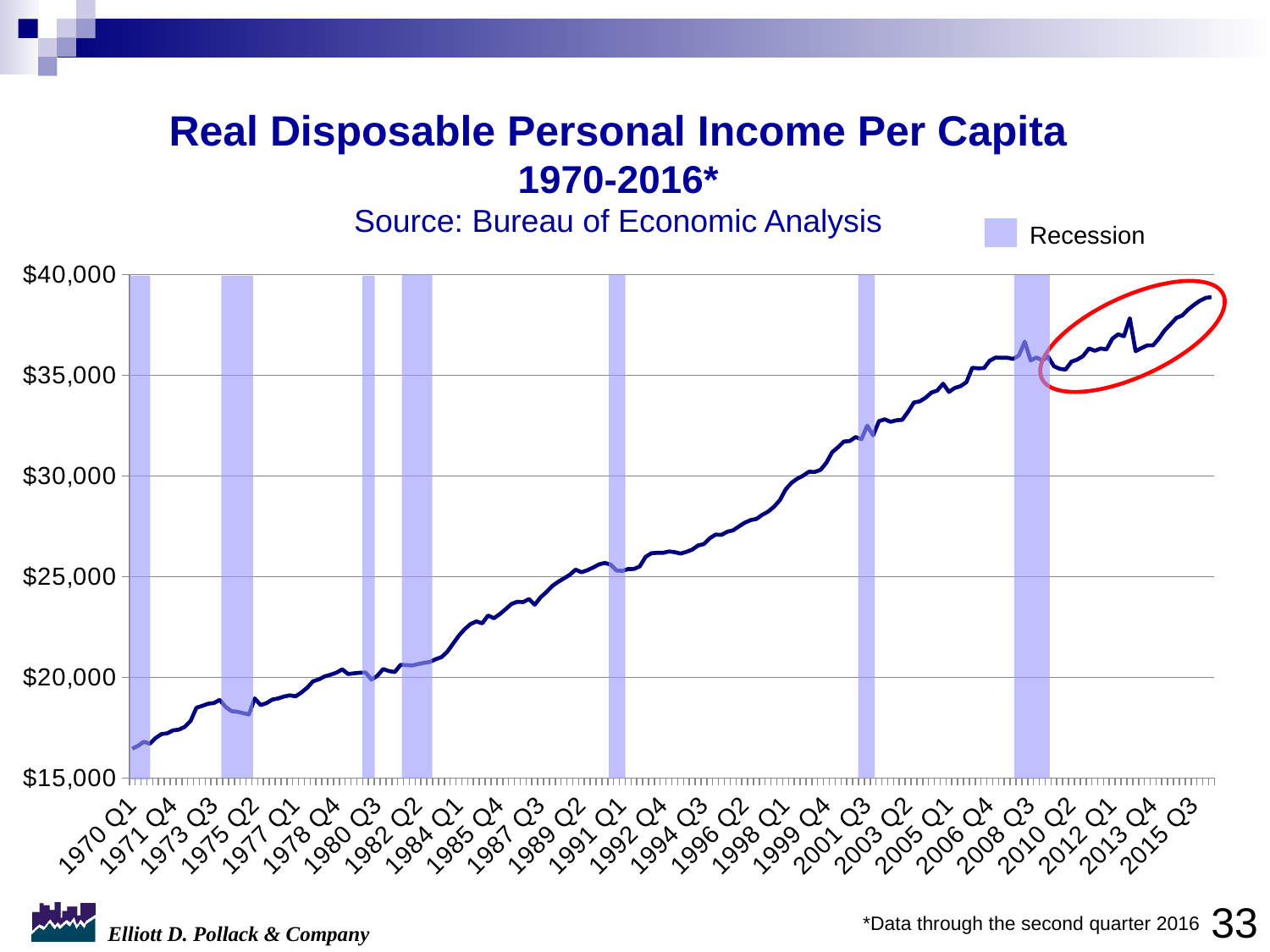
Is the value for 2015 Q3 greater or less than $35,000? greater What does the shaded area in the legend represent? Recession What is the title of the chart? Real Disposable Personal Income Per Capita 1970-2016* Is the value for 1970 Q1 greater or less than $20,000? less Which is larger, the value for 2015 Q3 or the value for 1970 Q1? 2015 Q3 Is the value for 1996 Q2 greater or less than $30,000? less What kind of chart is shown on the slide? line chart Overall, do the values rise or fall from 1970 Q1 to 2015 Q3? rise